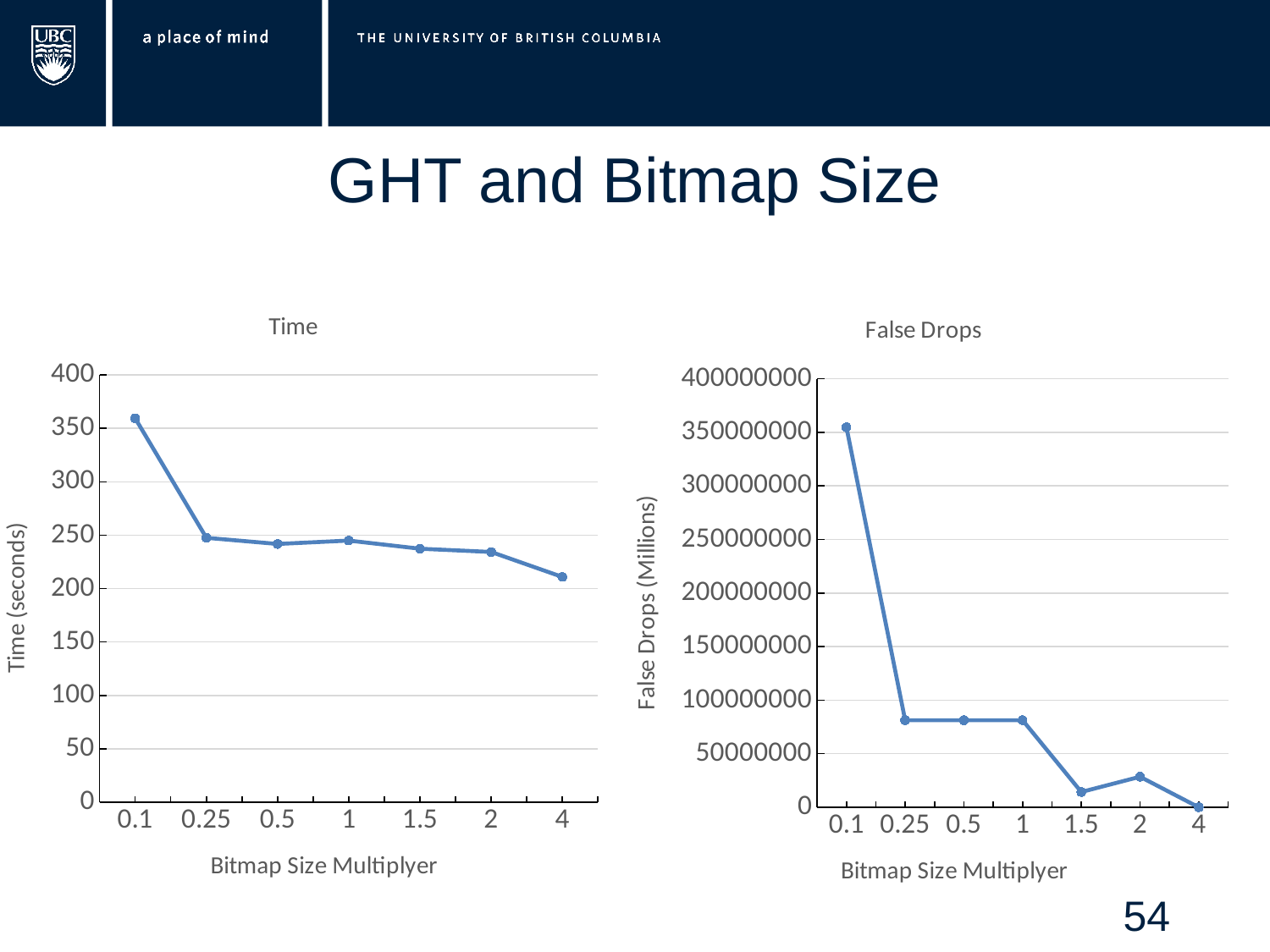
On the "Time" chart, which bitmap size multiplier has the lowest time? 4 What kind of chart is the "Time" chart on the left? line chart On the "Time" chart, do the values generally rise or fall as the bitmap size multiplier increases? fall On the "False Drops" chart, which has more false drops: bitmap size multiplier 1.5 or 2? 2 On the "False Drops" chart, which bitmap size multiplier has the highest number of false drops? 0.1 On the "Time" chart, is the value for bitmap size multiplier 0.1 greater or less than 300? greater On the "Time" chart, is the value for bitmap size multiplier 4 greater or less than 250? less What is the x-axis label of the "False Drops" chart? Bitmap Size Multiplyer On the "False Drops" chart, which bitmap size multiplier has the lowest number of false drops? 4 On the "Time" chart, which bitmap size multiplier has the highest time? 0.1 On the "False Drops" chart, is the value for bitmap size multiplier 0.25 greater or less than 1000000000? less How many data points are plotted on the "False Drops" chart? 7